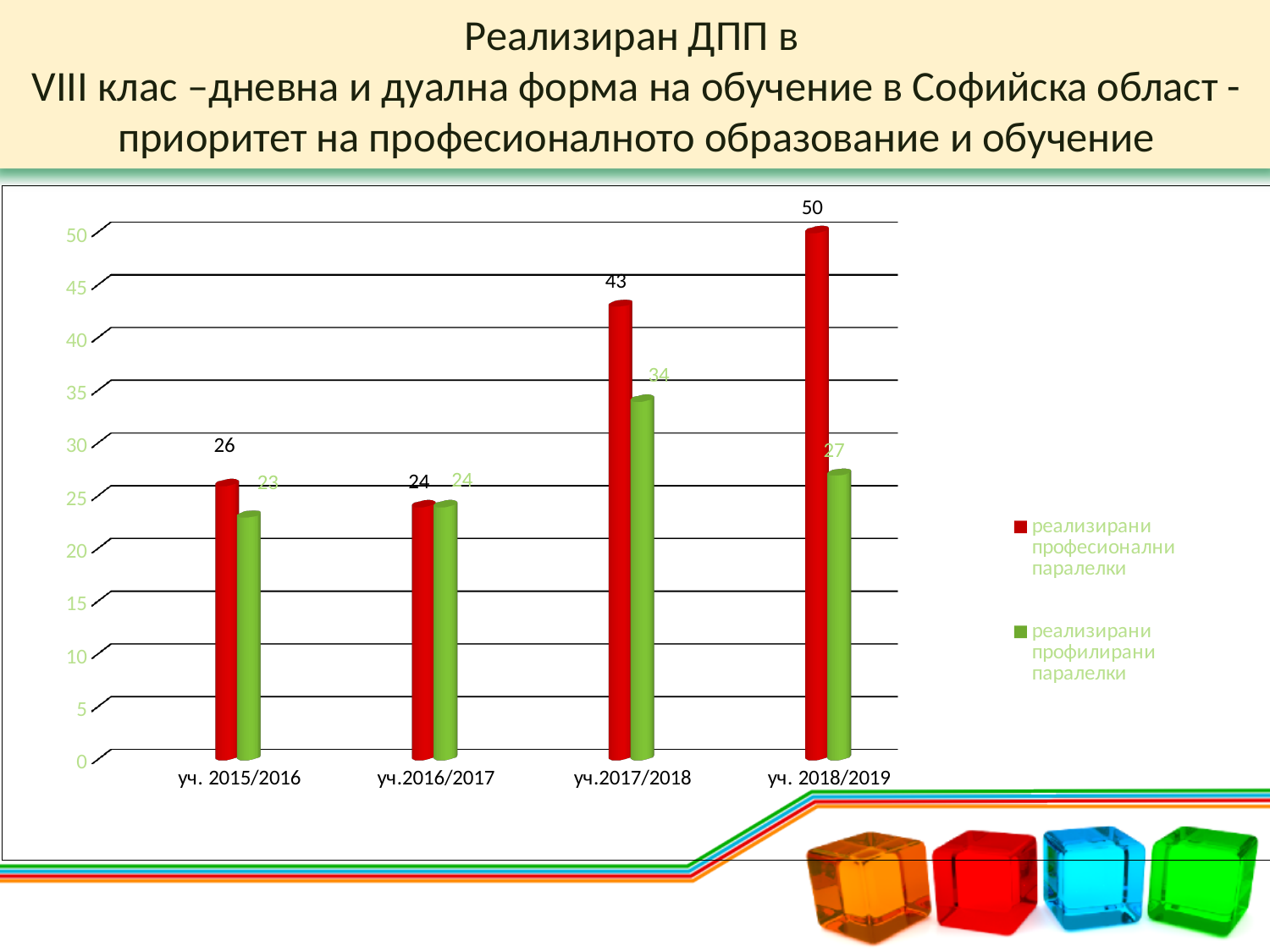
What is the value for реализирани профилирани паралелки in уч.2017/2018? 34 What is the value for реализирани професионални паралелки in уч. 2018/2019? 50 In which school year is the value for реализирани професионални паралелки highest? уч. 2018/2019 How many school years are shown on the x axis? 4 What is the value for реализирани професионални паралелки in уч. 2015/2016? 26 What kind of chart is shown on the slide? bar chart Which is larger in уч.2017/2018: реализирани професионални паралелки or реализирани профилирани паралелки? реализирани професионални паралелки How many series does the legend list? 2 What is the difference between реализирани професионални паралелки and реализирани профилирани паралелки in уч. 2018/2019? 23 Which colour represents реализирани профилирани паралелки in the chart? green What is the value for реализирани профилирани паралелки in уч. 2018/2019? 27 In which school year is the value for реализирани профилирани паралелки lowest? уч. 2015/2016